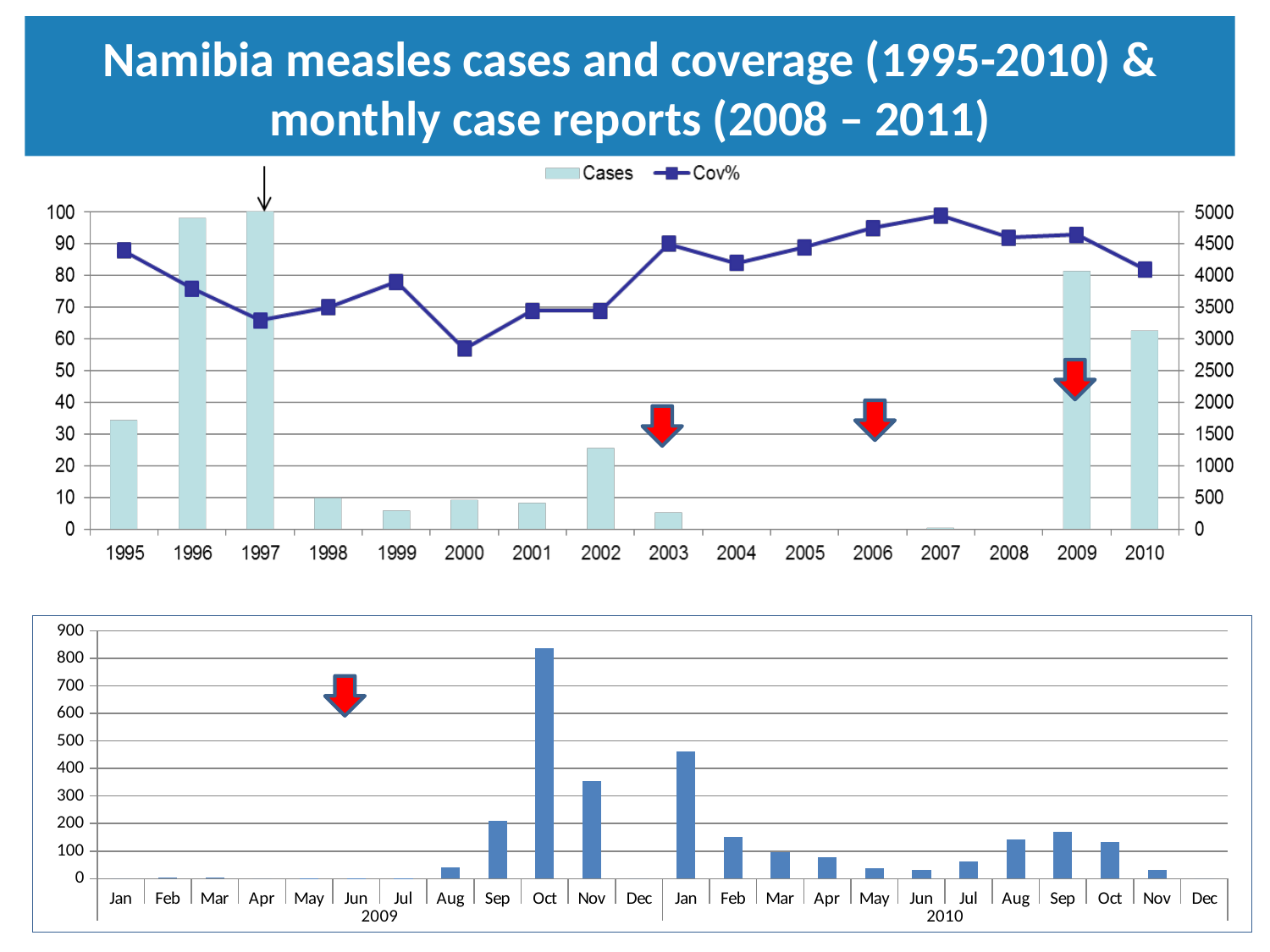
In the top chart, is the Cov% value for 2007 greater or less than 90? greater In the bottom chart, is the value for Oct 2009 greater or less than 800? greater In the top chart, which year has the lowest Cov% value? 2000 What kind of chart is the bottom chart? bar chart In the bottom chart, which is larger, the value for Nov 2009 or the value for Jan 2010? Jan 2010 In the top chart, which year has the tallest Cases bar? 1997 In the bottom chart, which month has the highest number of cases? Oct 2009 In the top chart, how many series does the legend list? 2 In the top chart, is the Cov% value for 2000 greater or less than 70? less In the top chart, does the Cov% line rise or fall from 1995 to 1997? fall In the top chart, which year has the highest Cov% value? 2007